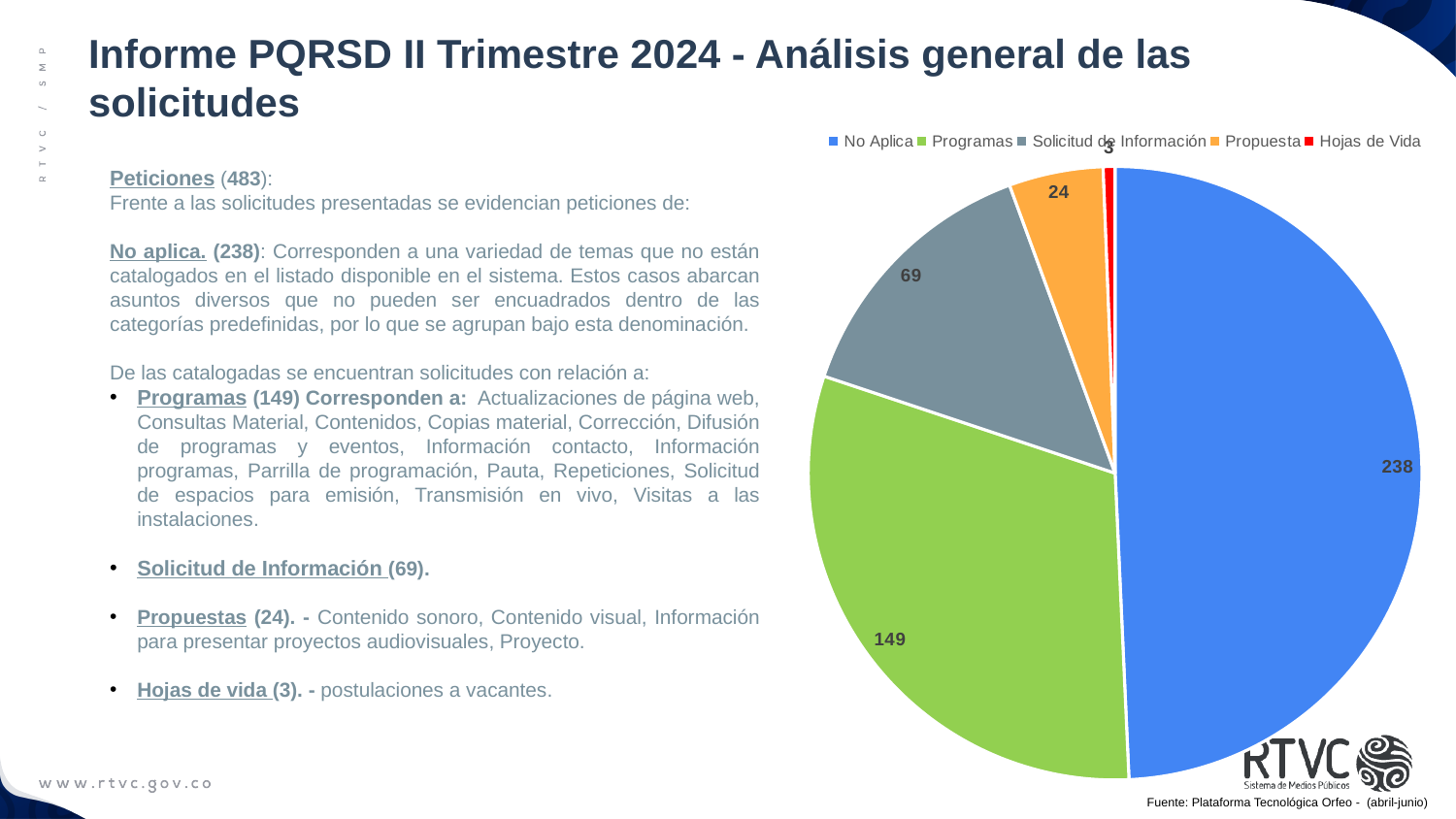
Which category has the largest slice in the pie chart? No Aplica What kind of chart is shown on the slide? pie chart How many categories does the pie chart show? 5 What colour is the Programas slice in the pie chart? green What is the difference between the values for No Aplica and Programas? 89 What is the total of all the slices in the pie chart? 483 Which is larger, the value for Solicitud de Información or the value for Propuesta? Solicitud de Información What is the value for Programas in the pie chart? 149 What is the value for No Aplica in the pie chart? 238 What is the value for Solicitud de Información in the pie chart? 69 What is the value for Propuesta in the pie chart? 24 Which category has the smallest slice in the pie chart? Hojas de Vida